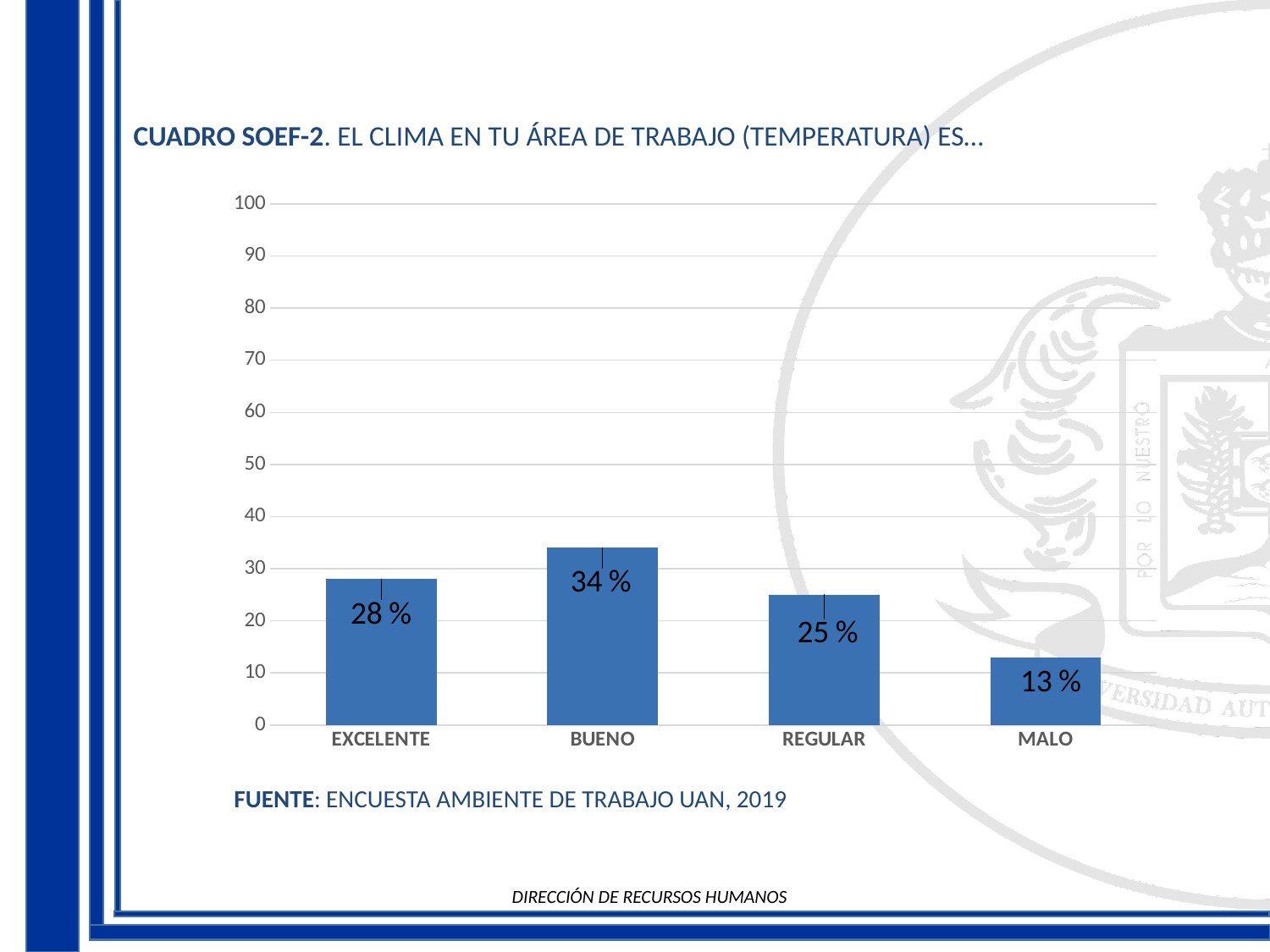
What is the value for MALO? 13 % Which category has the lowest value? MALO What is the difference between the values for BUENO and REGULAR? 9 % How many categories are shown on the x axis? 4 What is the highest value shown on the y axis? 100 Which is larger, the value for EXCELENTE or the value for REGULAR? EXCELENTE Which category has the highest value? BUENO What is the value for BUENO? 34 % What is the source cited below the chart? ENCUESTA AMBIENTE DE TRABAJO UAN, 2019 Is the value for BUENO greater or less than 30? greater What is the value for EXCELENTE? 28 % What kind of chart is shown on the slide? Bar chart